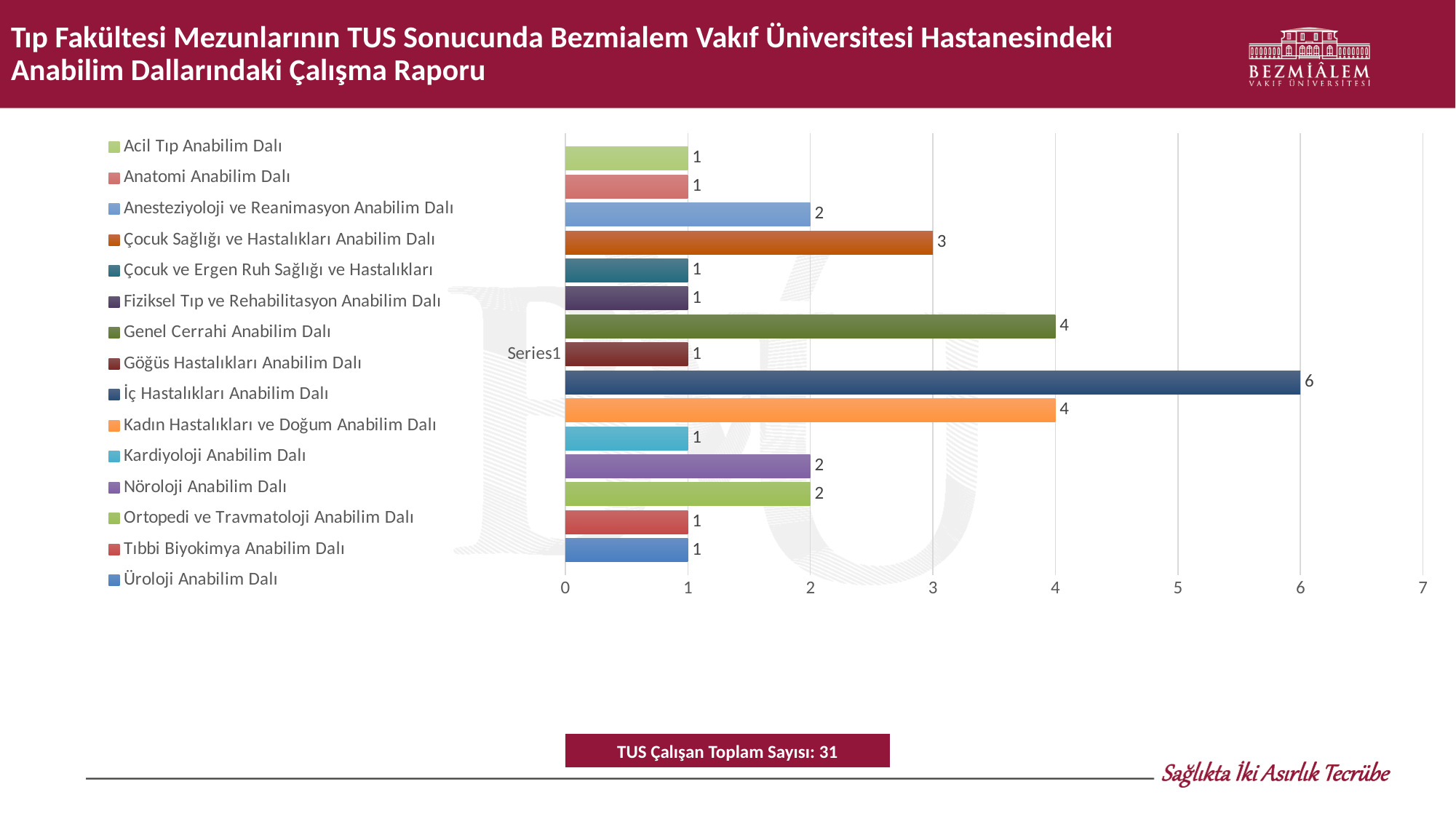
Which category has the highest value in the chart? İç Hastalıkları Anabilim Dalı How many categories (anabilim dalları) are listed in the chart legend? 15 What is the value for Kardiyoloji Anabilim Dalı? 1 What is the difference between the values for İç Hastalıkları Anabilim Dalı and Genel Cerrahi Anabilim Dalı? 2 What total number of TUS employees is stated in the box below the chart? 31 Is the value for Kadın Hastalıkları ve Doğum Anabilim Dalı greater or less than 3? greater Which is larger, the value for Anesteziyoloji ve Reanimasyon Anabilim Dalı or the value for Çocuk Sağlığı ve Hastalıkları Anabilim Dalı? Çocuk Sağlığı ve Hastalıkları Anabilim Dalı What is the value for İç Hastalıkları Anabilim Dalı? 6 What is the highest value shown on the horizontal axis of the chart? 7 What is the value for Çocuk Sağlığı ve Hastalıkları Anabilim Dalı? 3 What type of chart is shown on the slide? bar chart What is the value for Nöroloji Anabilim Dalı? 2